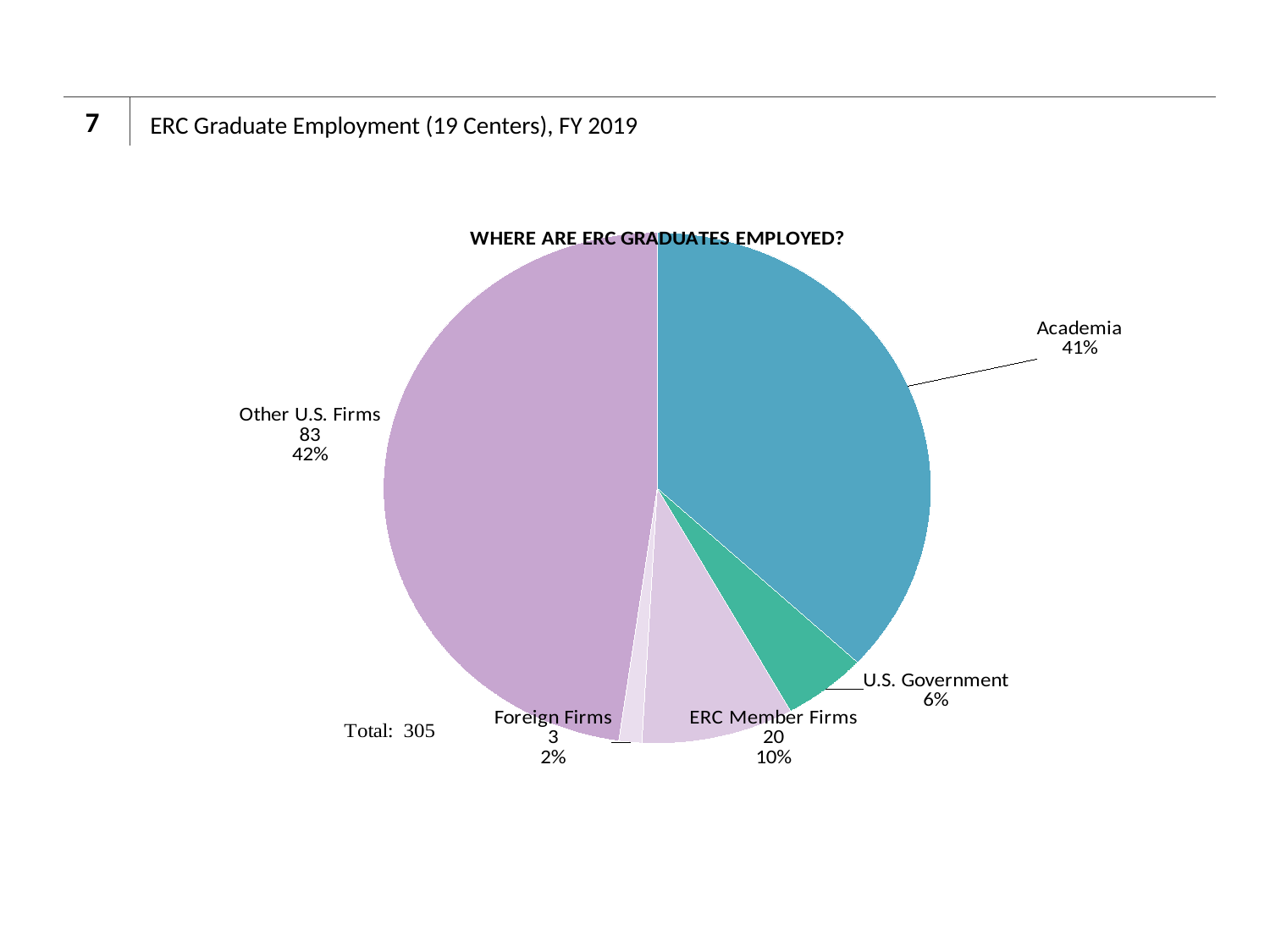
What kind of chart is shown on the slide? pie chart How many slices does the pie chart have? 5 What share of the pie does Foreign Firms represent? 2% What share of the pie does U.S. Government represent? 6% How many graduates are employed at ERC Member Firms? 20 Which category has the smallest slice of the pie? Foreign Firms Which category has the largest slice of the pie? Other U.S. Firms What share of the pie does Academia represent? 41% What is the difference between the number of graduates at Other U.S. Firms and at ERC Member Firms? 63 How many graduates are employed at Other U.S. Firms? 83 What is the title of the chart? WHERE ARE ERC GRADUATES EMPLOYED? What total number of graduates is shown on the slide? 305